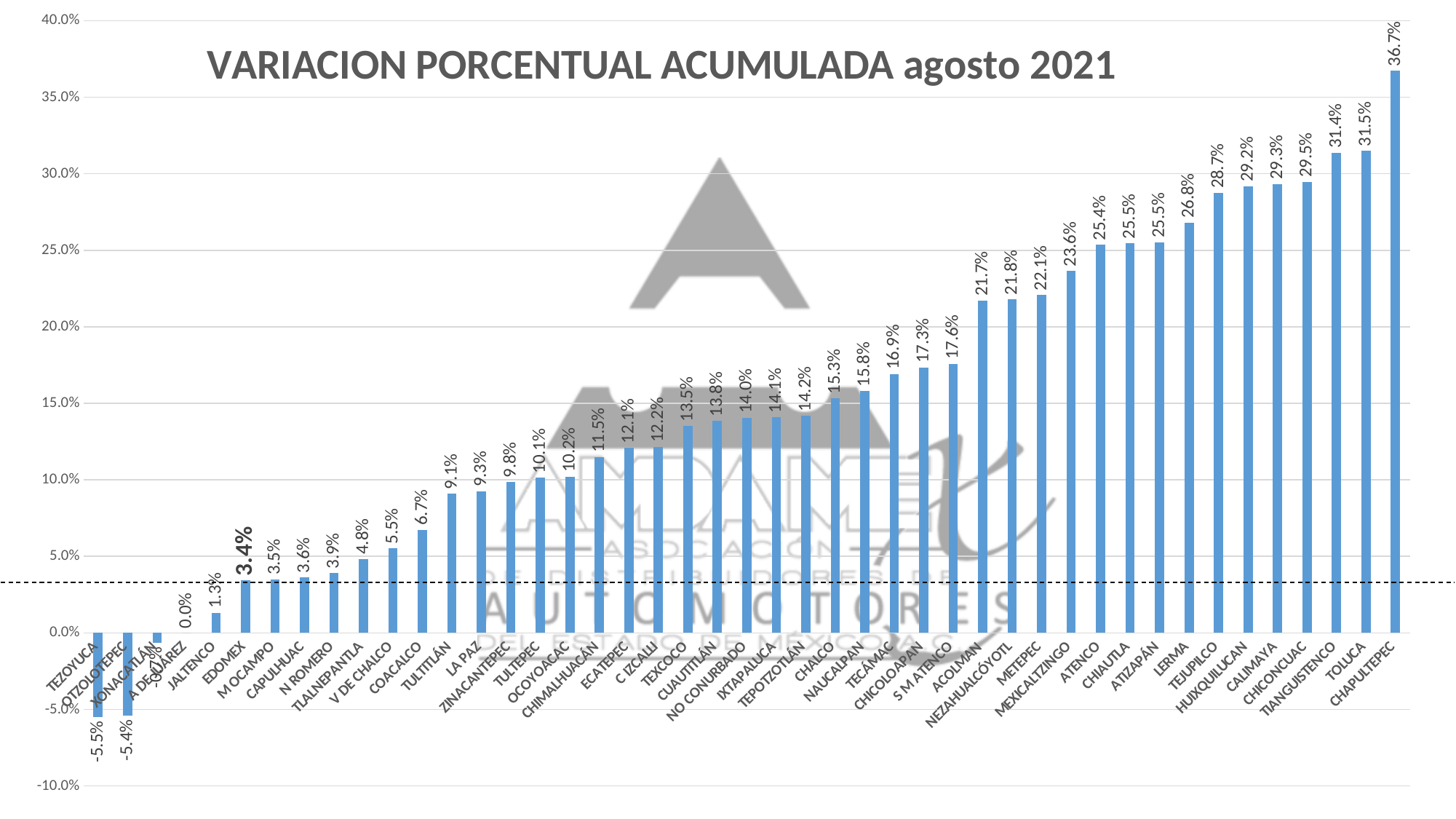
Which is larger, the value for NAUCALPAN or the value for CHALCO? NAUCALPAN What is the value for TOLUCA? 31.5% What is the value for EDOMEX? 3.4% Which category has the highest value? CHAPULTEPEC What is the value for ECATEPEC? 12.1% Is the value for LERMA greater or less than 25.0%? greater What is the difference between the values for CHAPULTEPEC and TOLUCA? 5.2% Do the values generally rise or fall from left to right along the x axis? rise What kind of chart is shown on the slide? bar chart Which category has the lowest value? TEZOYUCA What is the value for METEPEC? 22.1% What is the title of the chart? VARIACION PORCENTUAL ACUMULADA agosto 2021